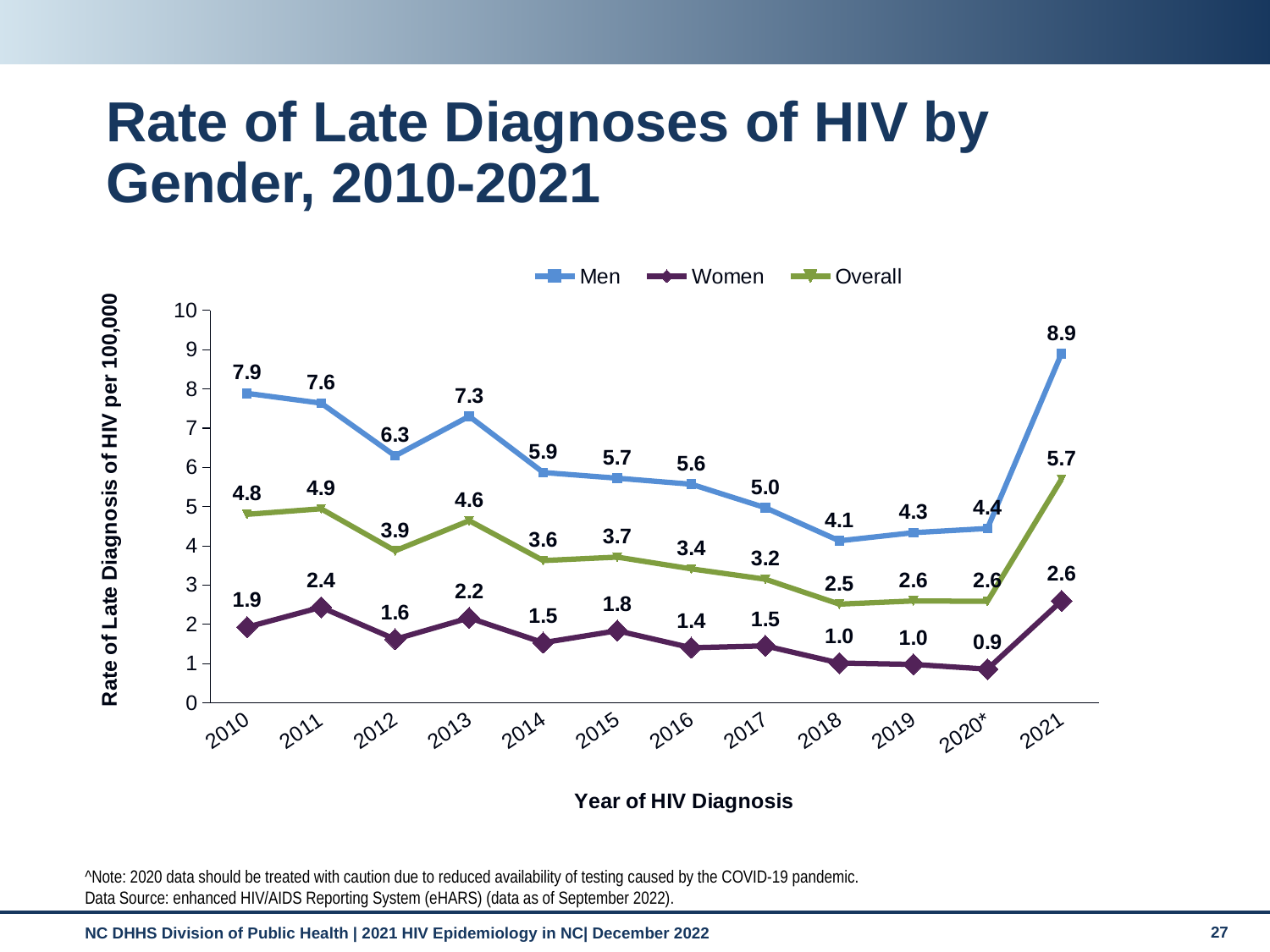
What is the Overall rate of late diagnosis of HIV in 2013? 4.6 How many series does the legend list? 3 In which year is the rate for Men the highest? 2021 What kind of chart is shown on the slide? Line chart What is the difference between the Men and Women rates in 2010? 6.0 What is the rate of late diagnosis of HIV for Women in 2020*? 0.9 What is the rate of late diagnosis of HIV for Men in 2021? 8.9 How many years are shown on the x axis? 12 Does the rate for Men rise or fall from 2010 to 2012? Fall Which series has the higher rate in 2015, Men or Overall? Men What is the label of the y axis? Rate of Late Diagnosis of HIV per 100,000 In which year is the rate for Men the lowest? 2018